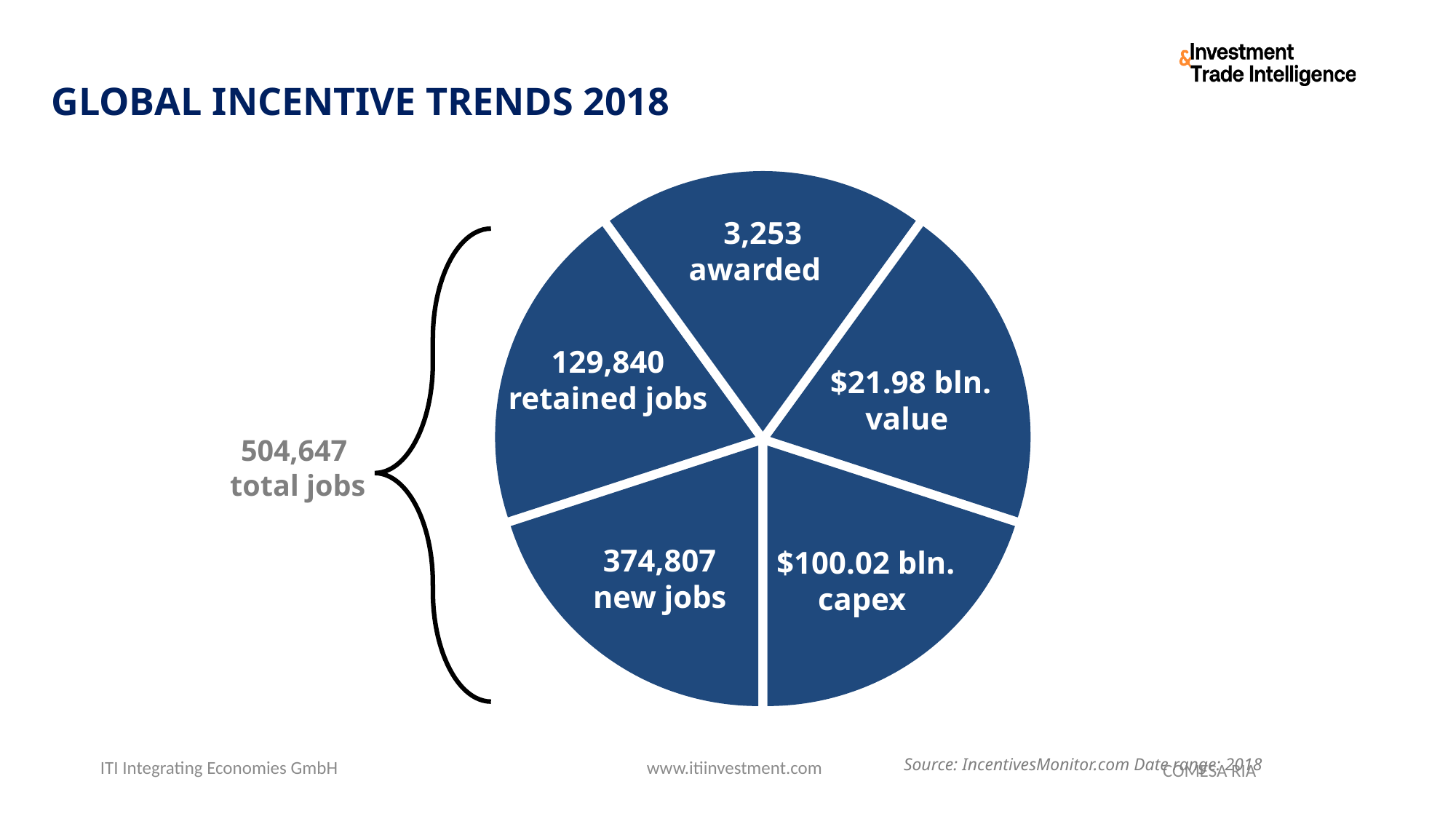
What capex figure is shown in the pie chart? $100.02 bln. What is the number of retained jobs shown in the pie chart? 129,840 How many slices does the pie chart have? 5 What kind of chart is shown on the slide? pie chart What is the total number of jobs indicated by the bracket next to the pie chart? 504,647 How many incentives were awarded according to the pie chart? 3,253 What is the number of new jobs shown in the pie chart? 374,807 What is the title of the slide containing the pie chart? GLOBAL INCENTIVE TRENDS 2018 What is the difference between the number of new jobs and the number of retained jobs? 244,967 Which is larger, the number of new jobs or the number of retained jobs? new jobs What is the sum of retained jobs and new jobs shown on the slide? 504,647 What value is shown in the pie chart slice labelled 'value'? $21.98 bln.